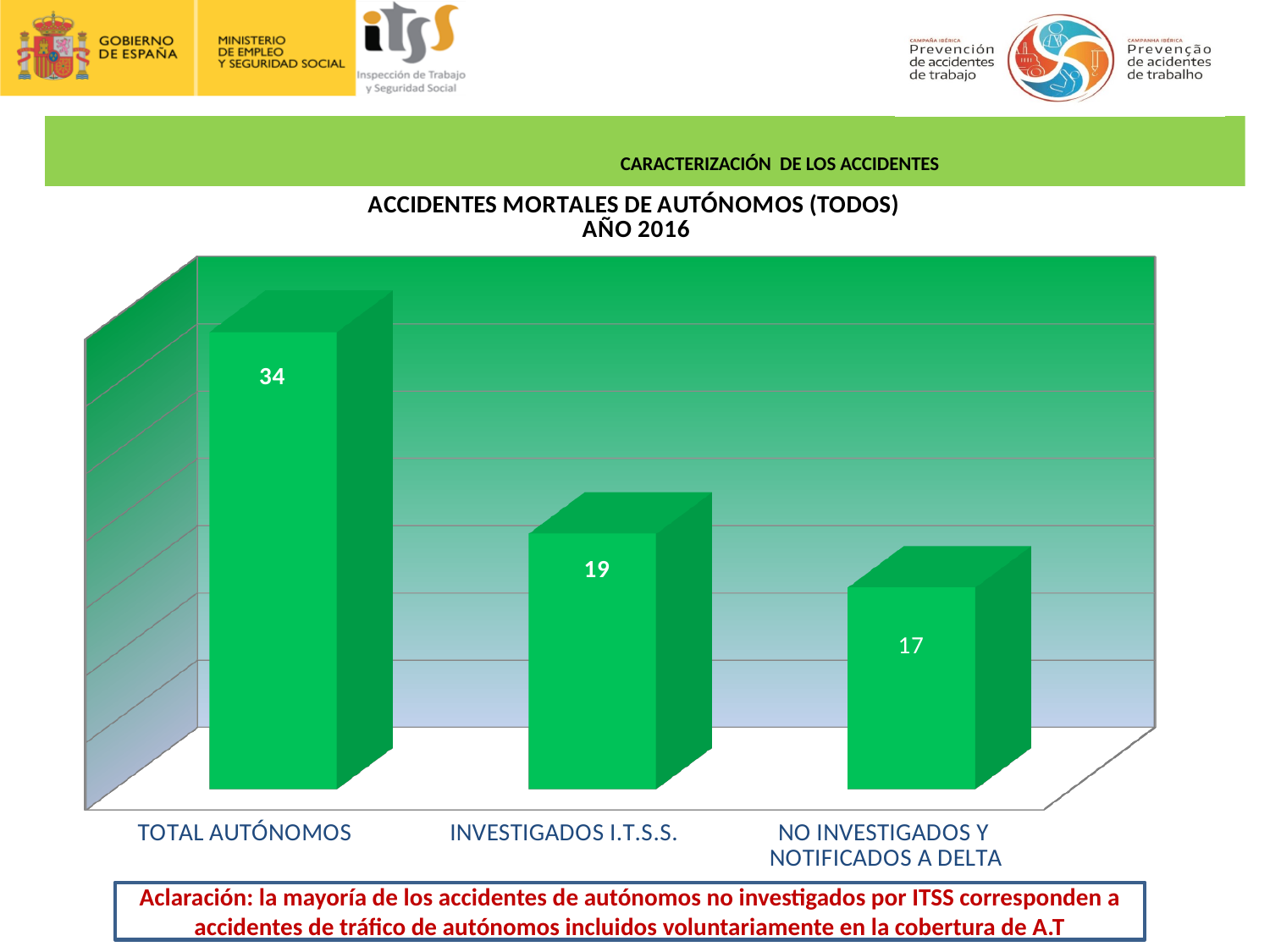
What is the difference between the values for TOTAL AUTÓNOMOS and INVESTIGADOS I.T.S.S.? 15 What is the value for INVESTIGADOS I.T.S.S.? 19 What is the value for TOTAL AUTÓNOMOS? 34 Which category has the lowest value? NO INVESTIGADOS Y NOTIFICADOS A DELTA What kind of chart is shown on the slide? Bar chart Which category has the highest value? TOTAL AUTÓNOMOS What is the difference between the values for INVESTIGADOS I.T.S.S. and NO INVESTIGADOS Y NOTIFICADOS A DELTA? 2 Do the values rise or fall from left to right across the categories? Fall What is the value for NO INVESTIGADOS Y NOTIFICADOS A DELTA? 17 What is the title of the chart? ACCIDENTES MORTALES DE AUTÓNOMOS (TODOS) AÑO 2016 How many categories are shown in the chart? 3 Which is larger, the value for INVESTIGADOS I.T.S.S. or the value for NO INVESTIGADOS Y NOTIFICADOS A DELTA? INVESTIGADOS I.T.S.S.